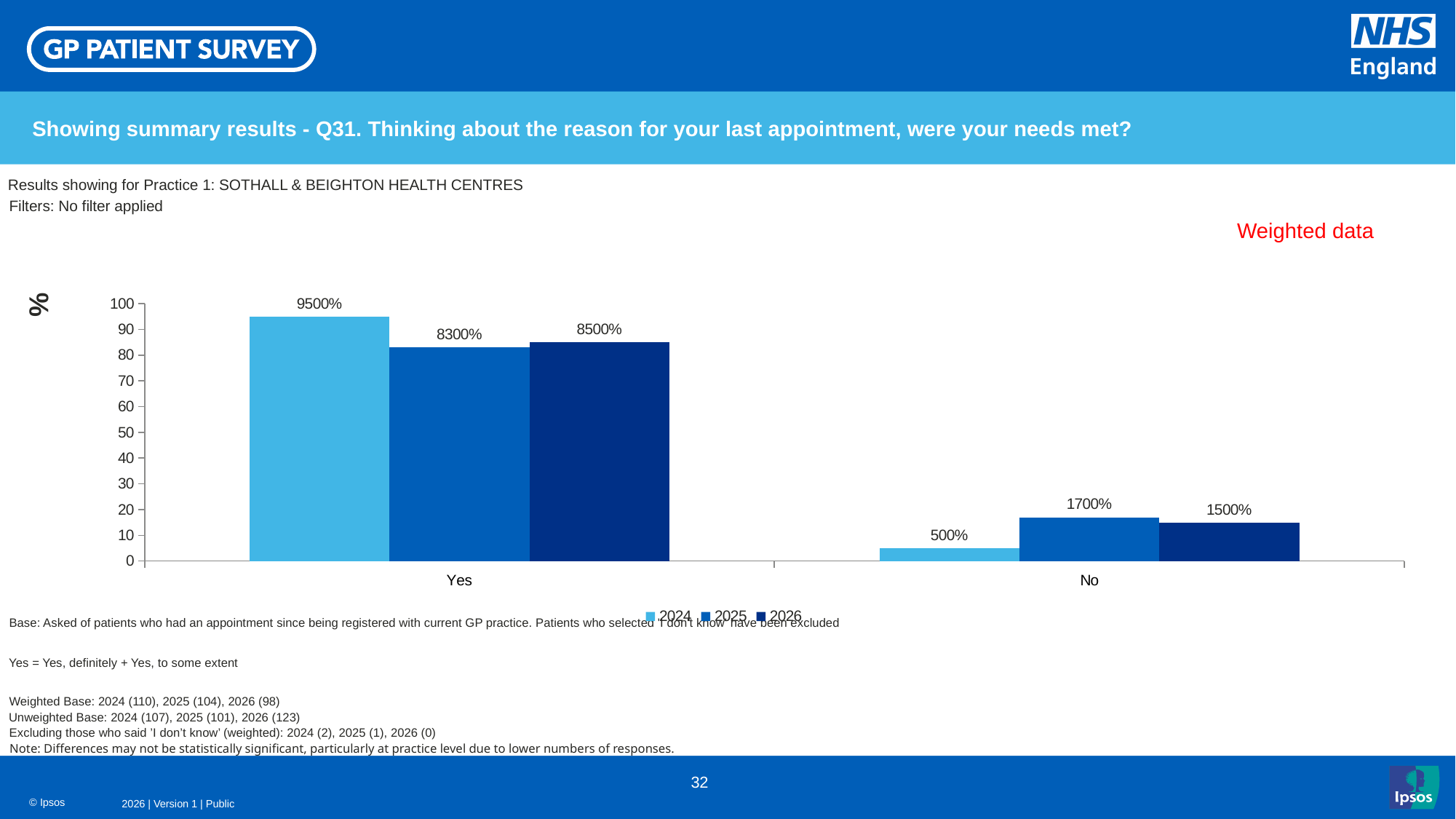
What is the data label shown for the 2026 bar in the No category? 1500% Which practice are the results shown for? Practice 1: SOTHALL & BEIGHTON HEALTH CENTRES Which year has the lowest bar in the No category? 2024 Which year has the highest bar in the Yes category? 2024 Is the 2025 bar in the No category greater or less than 10 on the axis? greater What is the data label shown for the 2024 bar in the Yes category? 9500% What kind of chart is shown on the slide? Bar chart How many categories are shown on the x axis? 2 What is the data label shown for the 2024 bar in the No category? 500% Is the 2025 bar in the Yes category taller than the 2026 bar in the Yes category? No How many series does the legend list? 3 What is the data label shown for the 2025 bar in the Yes category? 8300%